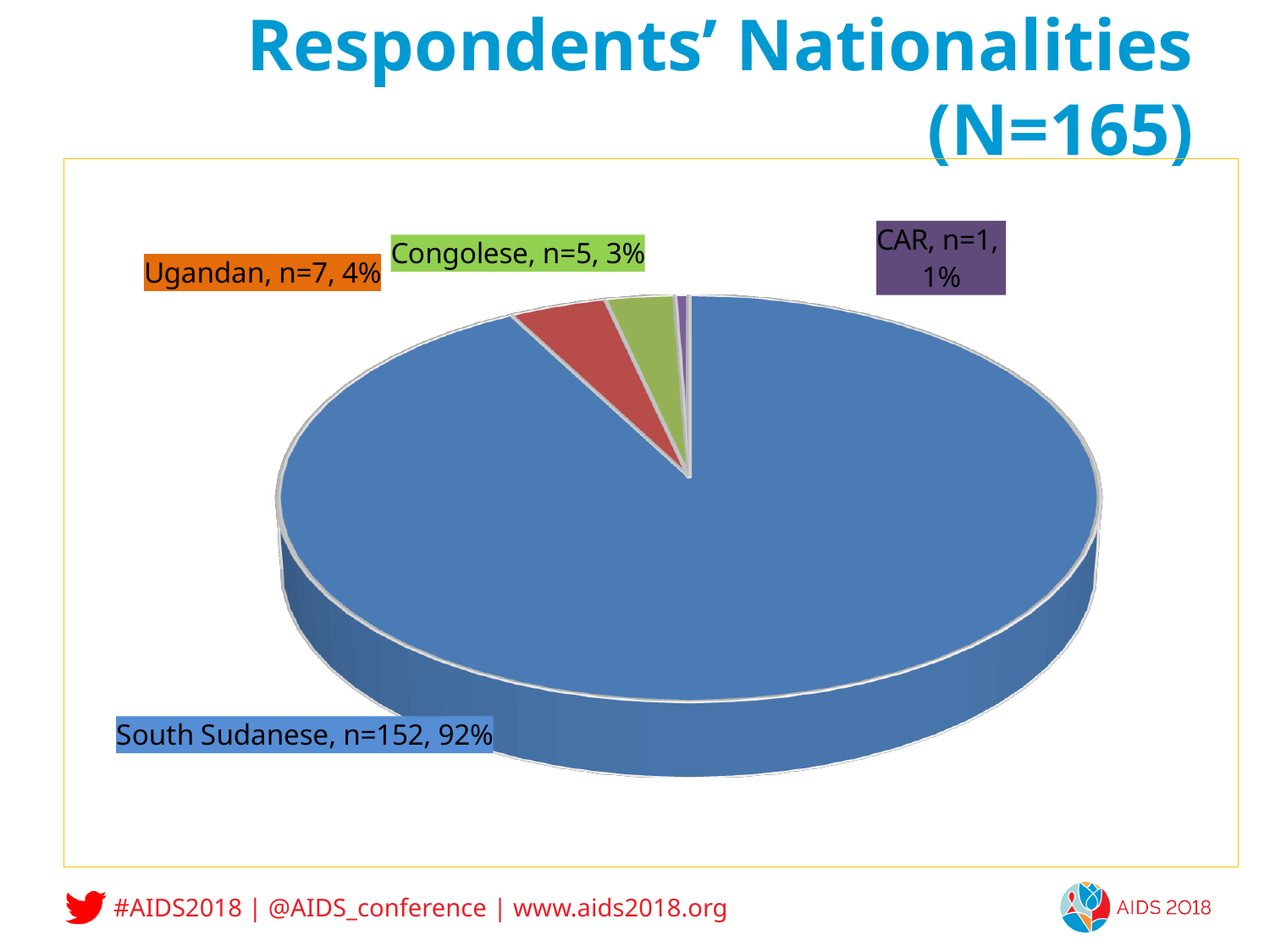
Which nationality has the largest share of respondents? South Sudanese Which nationality has the smallest share of respondents? CAR How many nationality categories are shown in the pie chart? 4 How many respondents are Congolese? 5 How many respondents are South Sudanese? 152 What is the share of the pie for South Sudanese respondents? 92% Which group has more respondents, Congolese or CAR? Congolese How many more Ugandan respondents are there than Congolese respondents? 2 What is the title of the chart? Respondents' Nationalities (N=165) What kind of chart is shown on the slide? Pie chart What percentage of respondents are from CAR? 1% What percentage of respondents are Ugandan? 4%